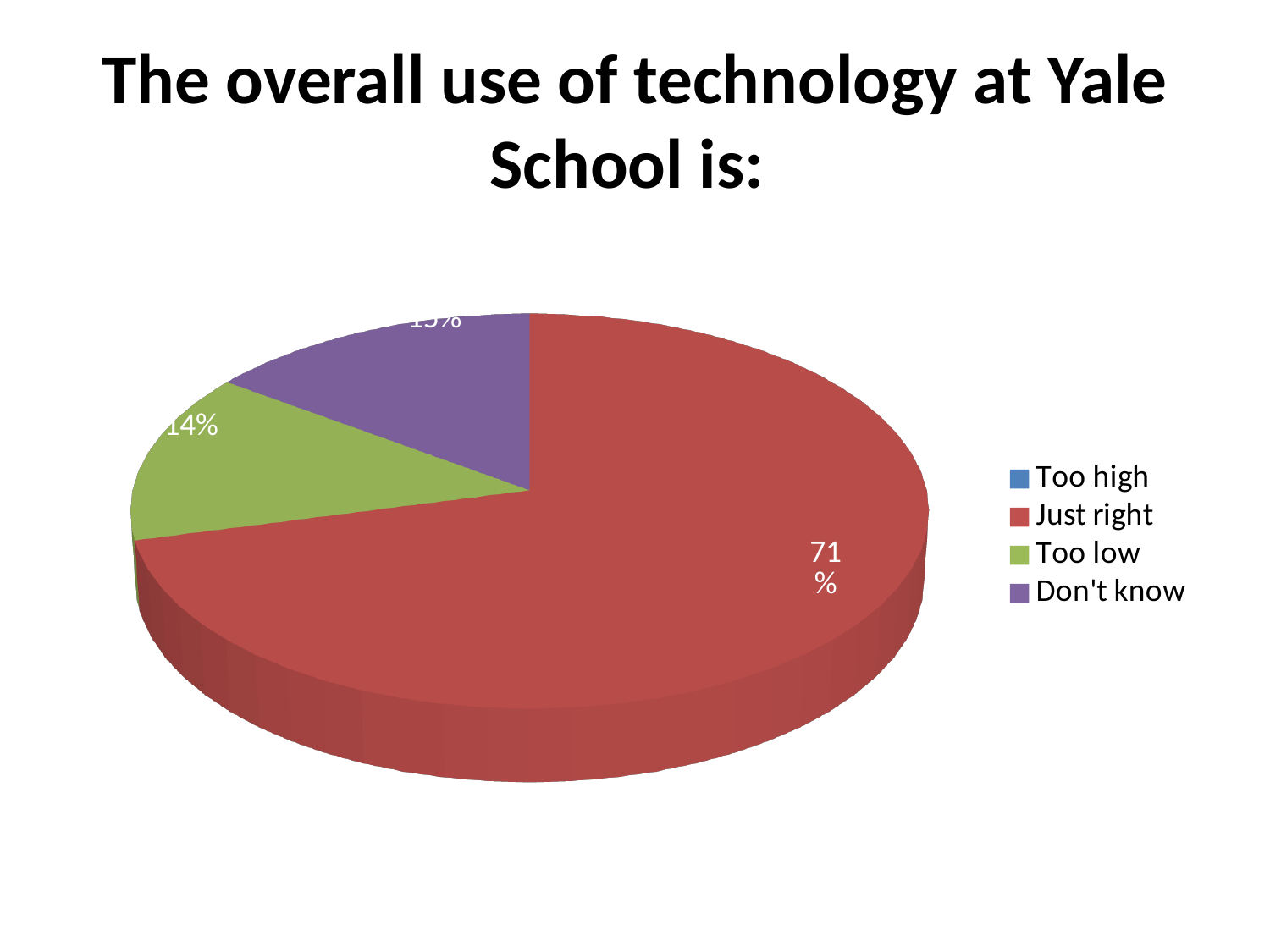
Which response has the largest slice of the pie? Just right How many entries does the legend list? 4 What kind of chart is shown on the slide? pie chart What is the difference in percentage points between the 'Just right' and 'Too low' slices? 57% What is the title of the chart? The overall use of technology at Yale School is: Which is larger, the 'Just right' slice or the 'Too low' slice? Just right What share of the pie does the 'Just right' slice take up? 71% What colour is the 'Just right' slice? red How many slices are visible in the pie? 3 What percentage of respondents said the use of technology is 'Just right'? 71% What percentage of respondents said the use of technology is 'Too low'? 14%